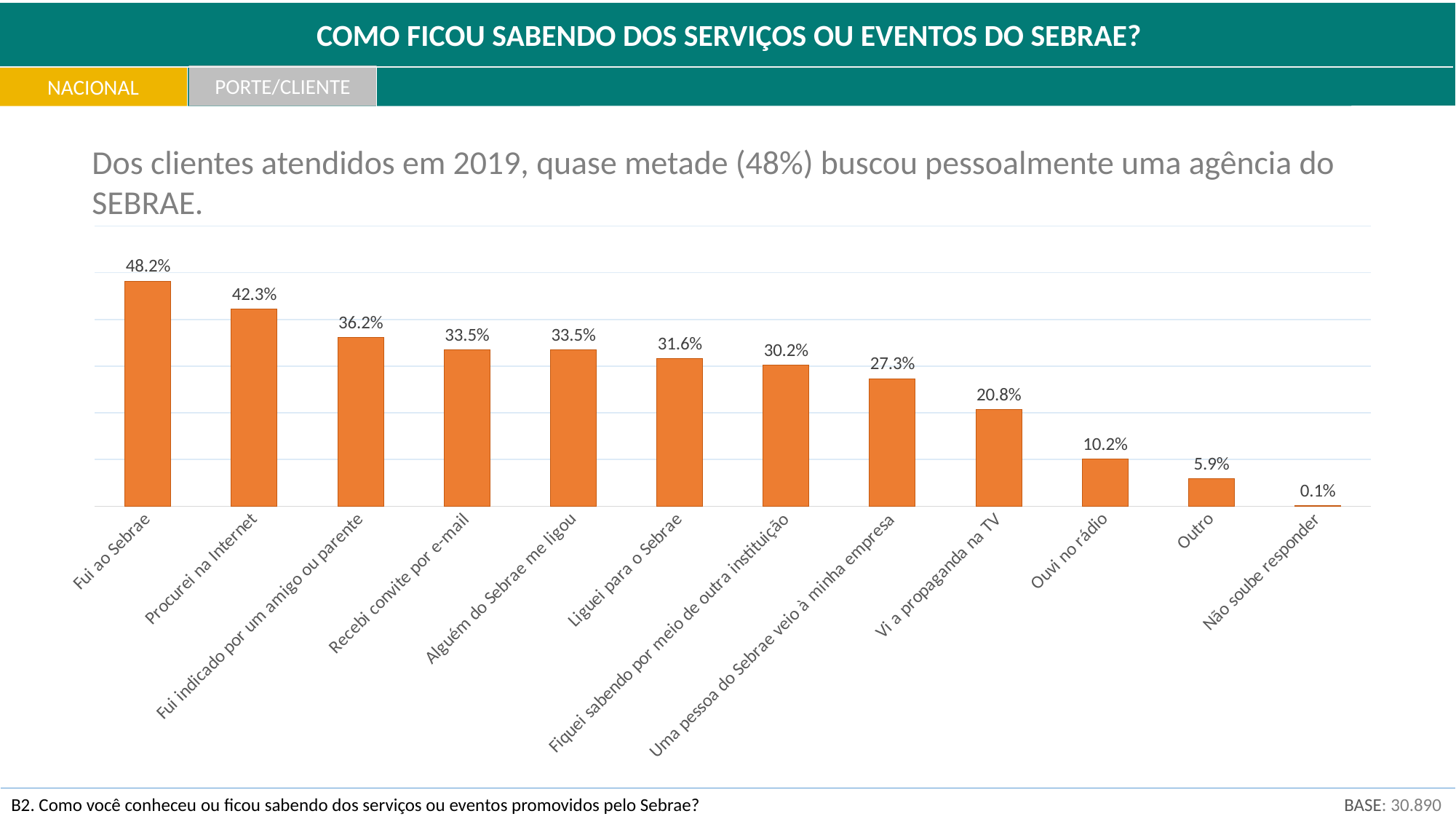
What kind of chart is shown on the slide? Bar chart What is the value for "Procurei na Internet"? 42.3% What is the value for "Fui ao Sebrae"? 48.2% What is the value for "Outro"? 5.9% Which category has the highest value? Fui ao Sebrae How many categories are shown in the chart? 12 What is the difference between "Fui ao Sebrae" and "Procurei na Internet"? 5.9% What is the value for "Ouvi no rádio"? 10.2% Which category has the lowest value? Não soube responder What is the value for "Vi a propaganda na TV"? 20.8% Which is larger, "Liguei para o Sebrae" or "Fiquei sabendo por meio de outra instituição"? Liguei para o Sebrae Do the values rise or fall from left to right along the x axis? Fall